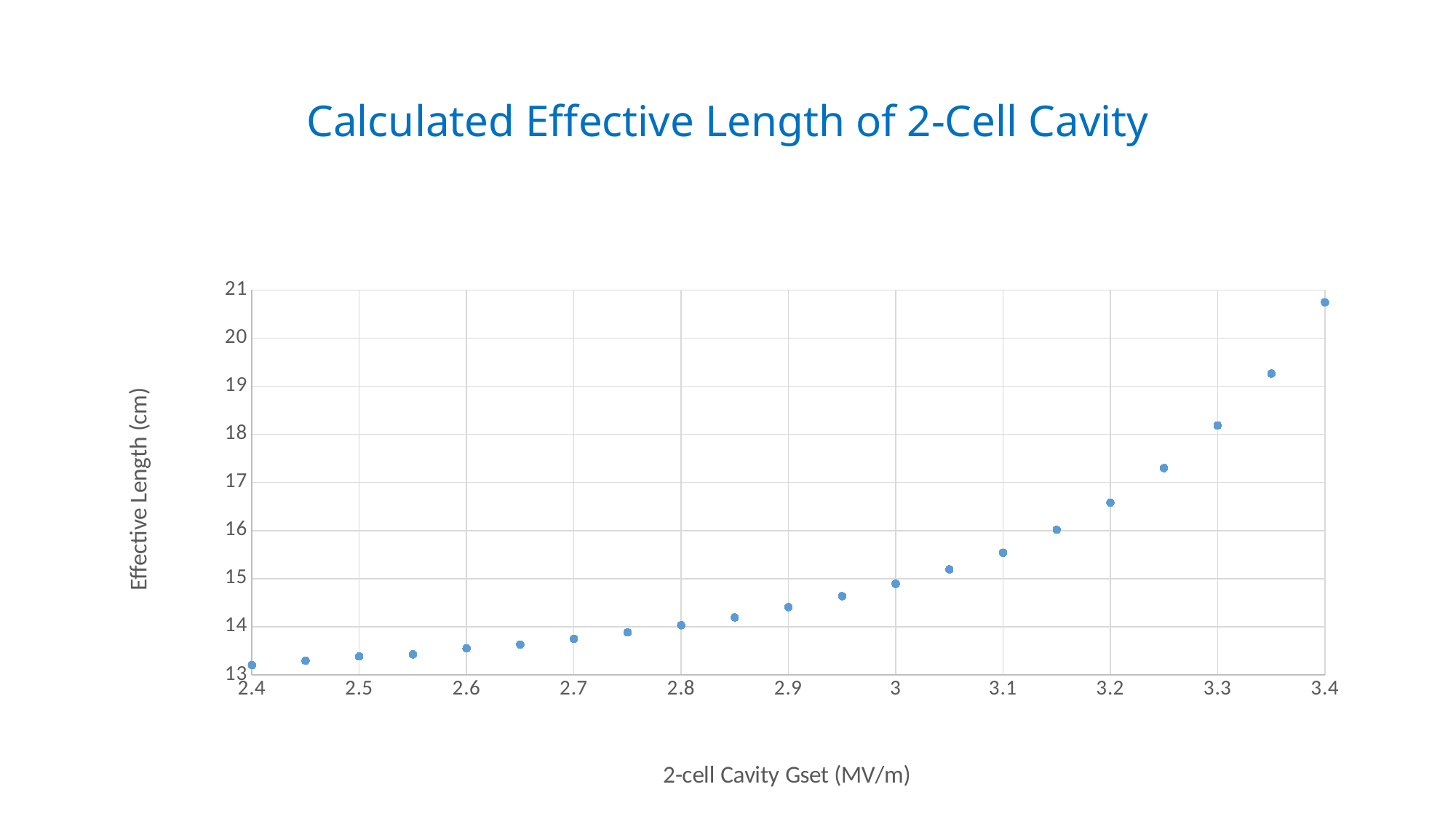
What kind of chart is shown on the slide? scatter chart What is the title of the chart? Calculated Effective Length of 2-Cell Cavity Is the effective length at a Gset of 2.4 MV/m greater or less than 14? less At which 2-cell Cavity Gset value is the effective length lowest? 2.4 How many data points are plotted on the chart? 21 Is the effective length at a Gset of 3.1 MV/m greater or less than 16? less Is the effective length at a Gset of 3.4 MV/m greater or less than 20? greater What is the label of the y axis? Effective Length (cm) Which has the larger effective length: a Gset of 2.6 MV/m or 3.3 MV/m? 3.3 MV/m Do the effective length values rise or fall as the 2-cell Cavity Gset increases along the x axis? rise At which 2-cell Cavity Gset value is the effective length highest? 3.4